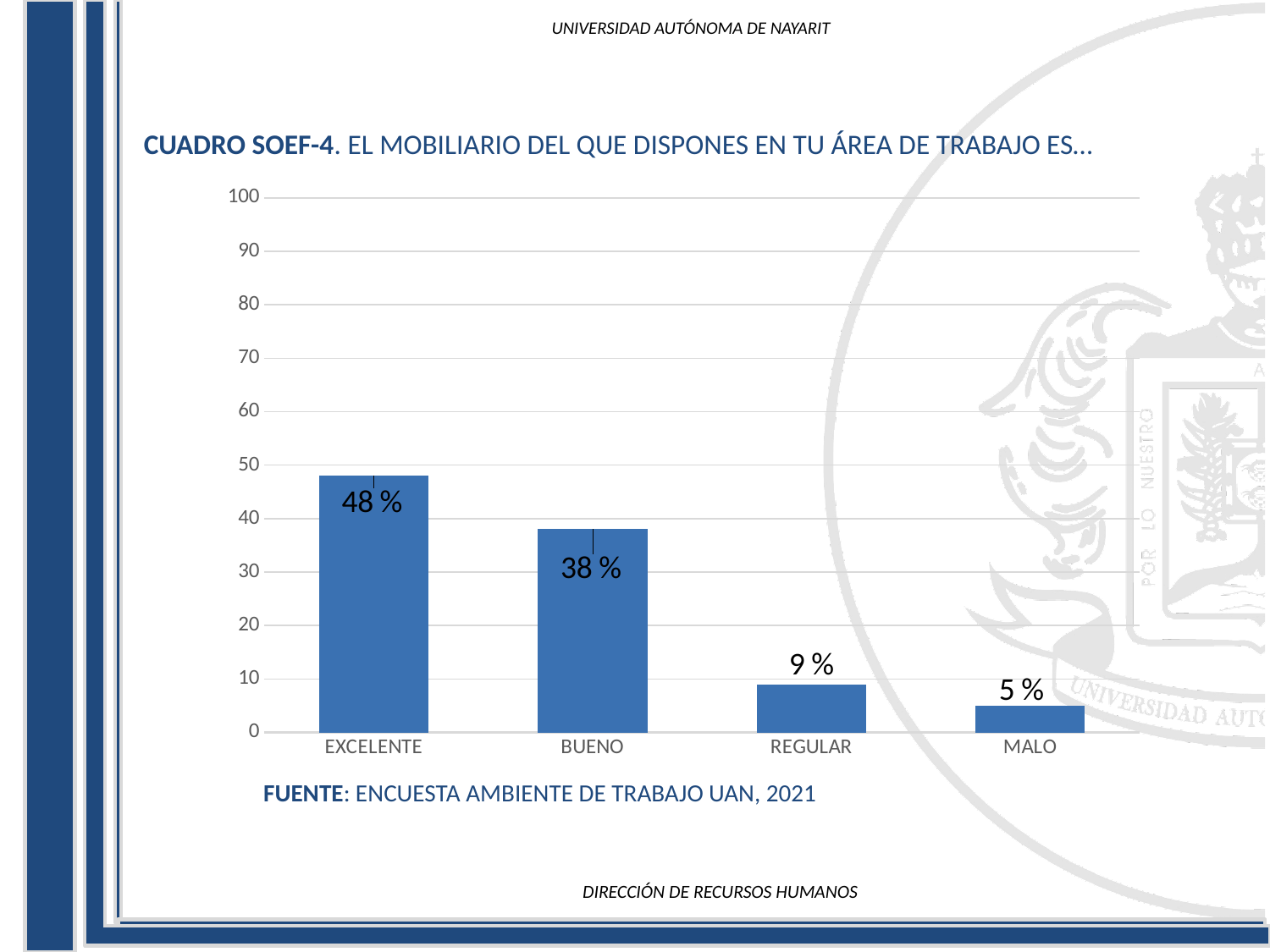
Do the values rise or fall from left to right along the x axis? fall What is the value for REGULAR? 9 % How many categories are shown on the x axis? 4 Which category has the lowest value? MALO What is the value for MALO? 5 % What is the value for EXCELENTE? 48 % Which is larger, the value for REGULAR or the value for MALO? REGULAR What is the difference between the values for EXCELENTE and BUENO? 10 % Which category has the highest value? EXCELENTE What is the value for BUENO? 38 % Is the value for BUENO greater or less than 40? less What kind of chart is shown on the slide? bar chart